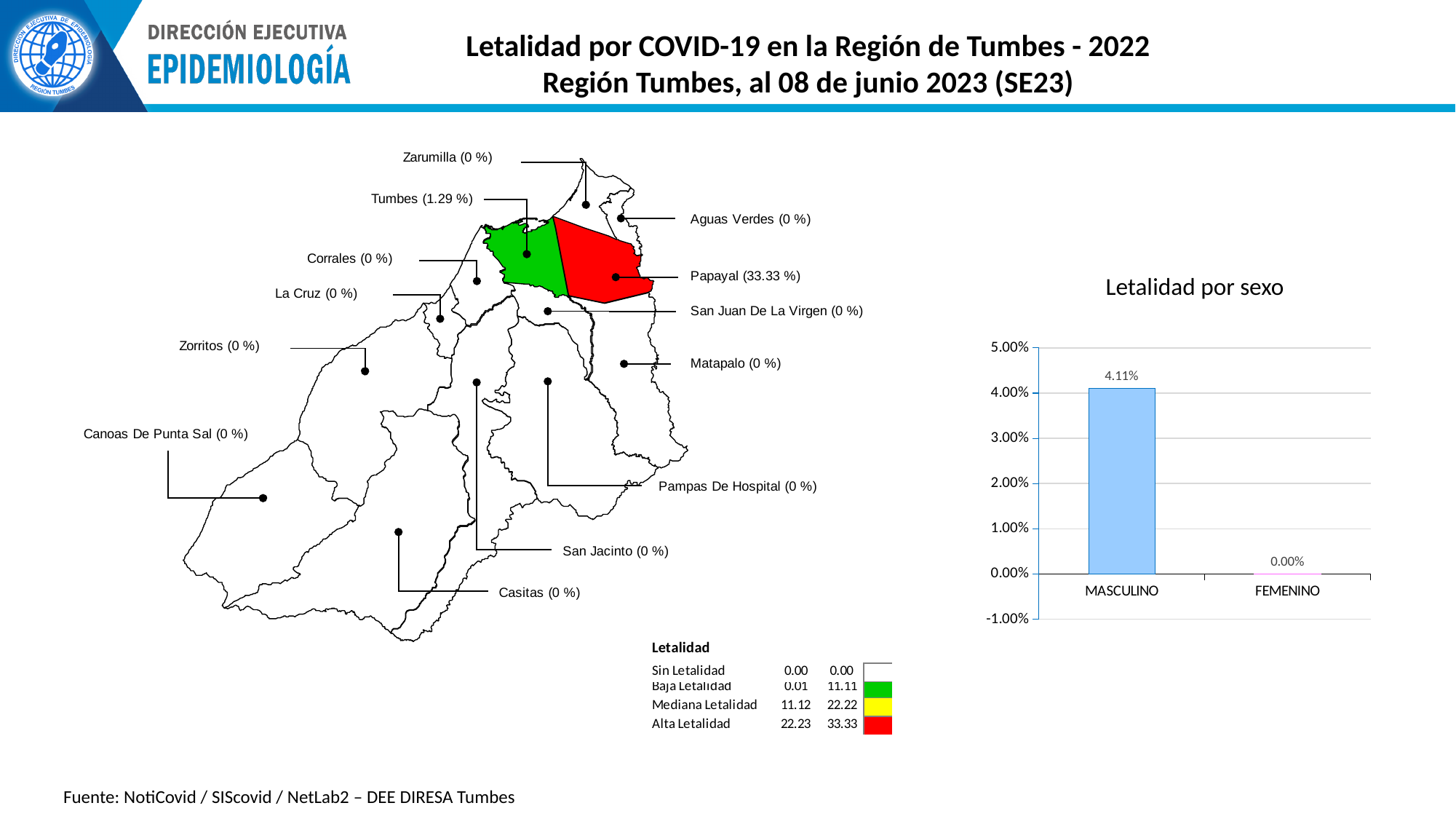
In the 'Letalidad por sexo' chart, what is the value for MASCULINO? 4.11% What is the title of the chart on the right side of the slide? Letalidad por sexo In the 'Letalidad por sexo' chart, which category has the lowest value? FEMENINO On the map, what is the lethality value shown for Tumbes? 1.29 % In the 'Letalidad por sexo' chart, what is the value for FEMENINO? 0.00% What kind of chart is 'Letalidad por sexo'? bar chart In the 'Letalidad por sexo' chart, is the value for MASCULINO greater or less than 3.00%? greater How many categories are shown in the 'Letalidad por sexo' chart? 2 In the 'Letalidad por sexo' chart, what is the difference between the MASCULINO and FEMENINO values? 4.11% On the map, what is the lethality value shown for Papayal? 33.33 % In the 'Letalidad por sexo' chart, is the value for MASCULINO greater or less than 5.00%? less In the 'Letalidad por sexo' chart, which category has the highest value? MASCULINO